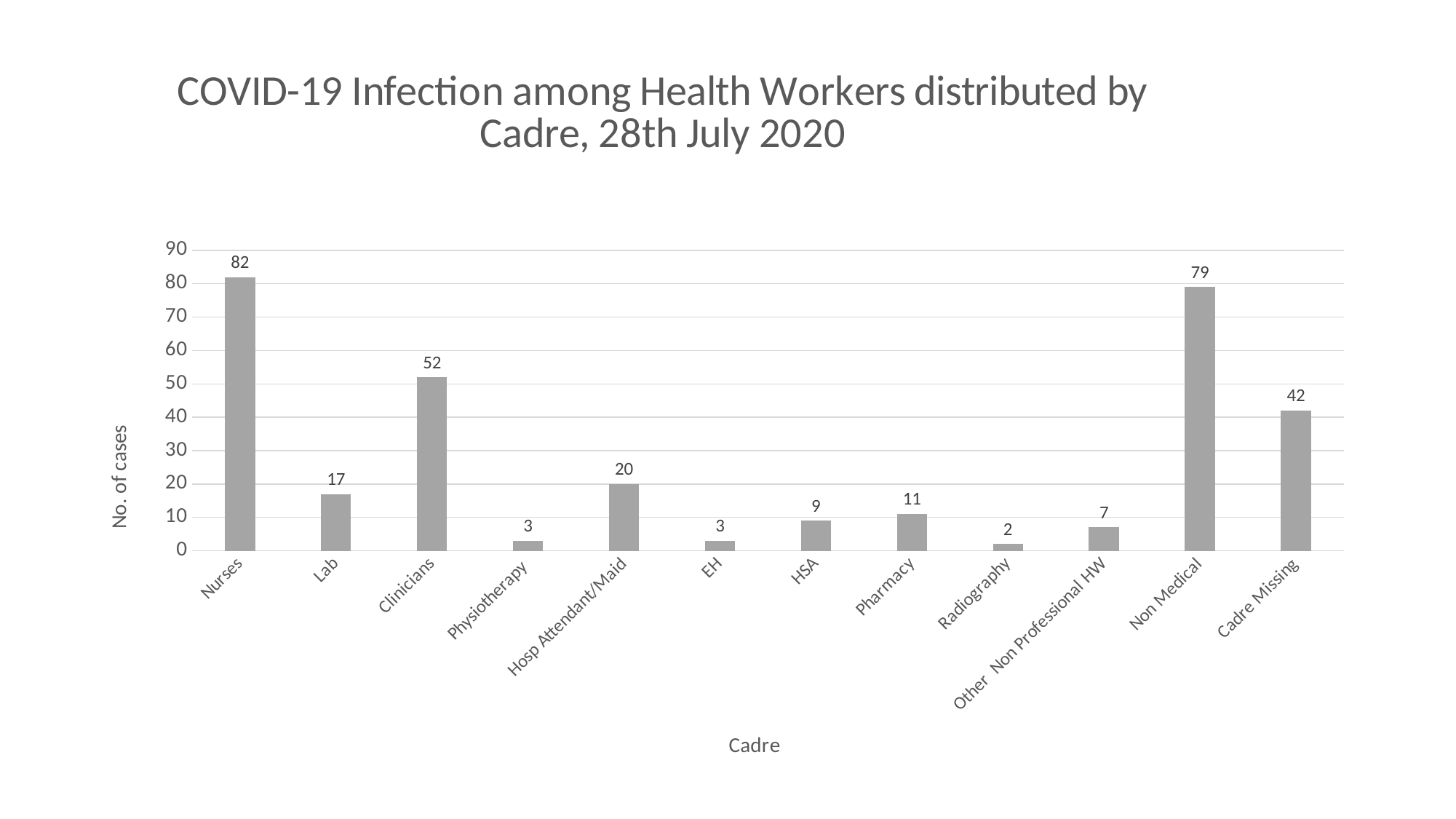
What is the number of cases for Nurses? 82 What is the number of cases for Clinicians? 52 How many cadres are shown on the x axis? 12 What kind of chart is shown on the slide? Bar chart What is the difference in cases between Nurses and Non Medical? 3 What is the difference in cases between Clinicians and Cadre Missing? 10 Which has more cases, Lab or Pharmacy? Lab Which has more cases, HSA or Other Non Professional HW? HSA Which cadre has the lowest number of cases? Radiography Which cadre has the highest number of cases? Nurses What is the number of cases for Hosp Attendant/Maid? 20 What is the label of the y axis? No. of cases